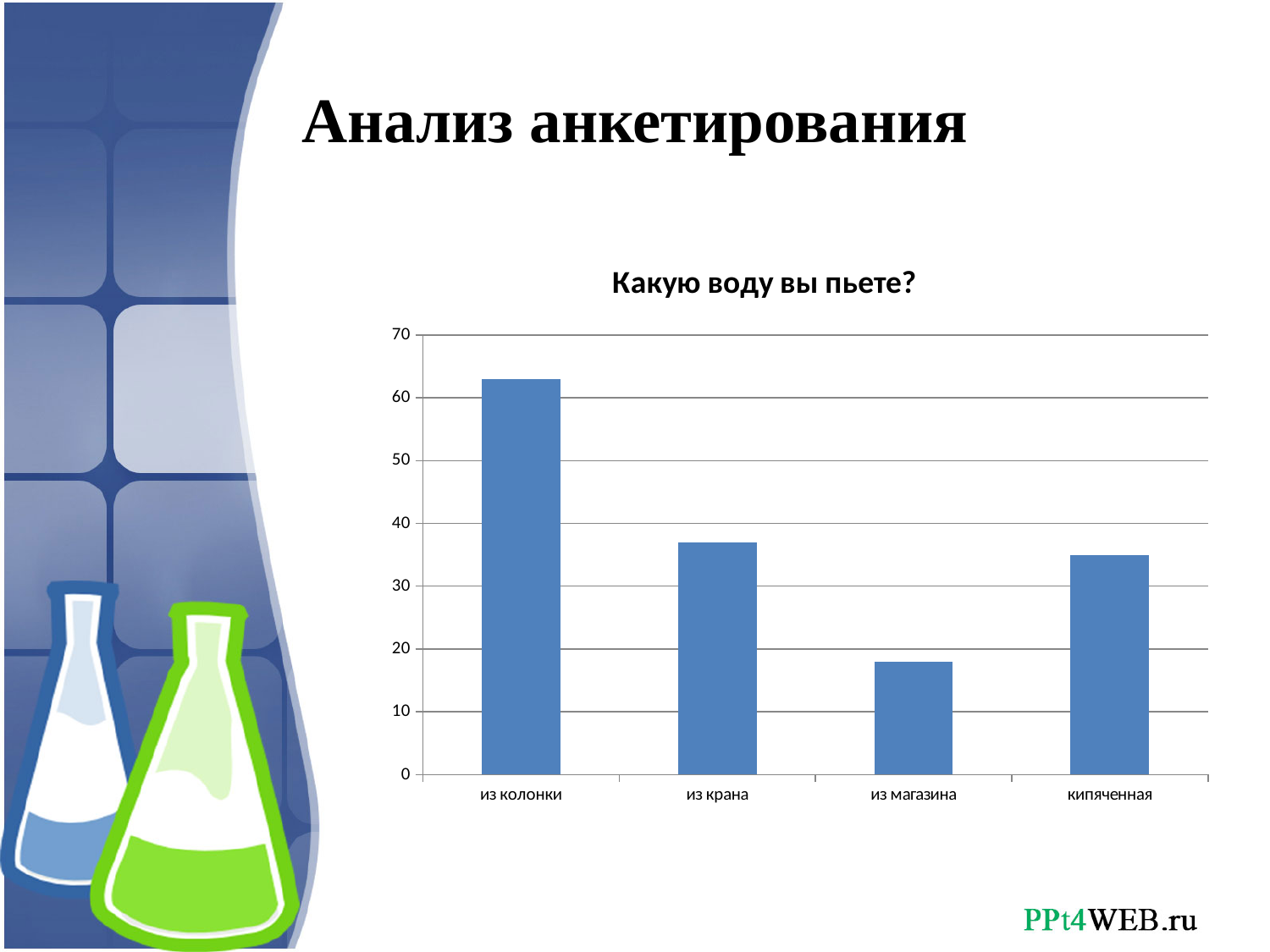
What kind of chart is shown on the slide? bar chart Is the value for из магазина greater or less than 20? less Which category has the lowest bar? из магазина Which is larger, the value for из колонки or the value for из крана? из колонки Is the value for кипяченная greater or less than 30? greater Which category has the highest bar? из колонки What is the title of the chart? Какую воду вы пьете? Which is larger, the value for из магазина or the value for кипяченная? кипяченная What is the maximum value shown on the y axis of the chart? 70 How many categories are shown on the x axis of the chart? 4 Is the value for из крана greater or less than 40? less